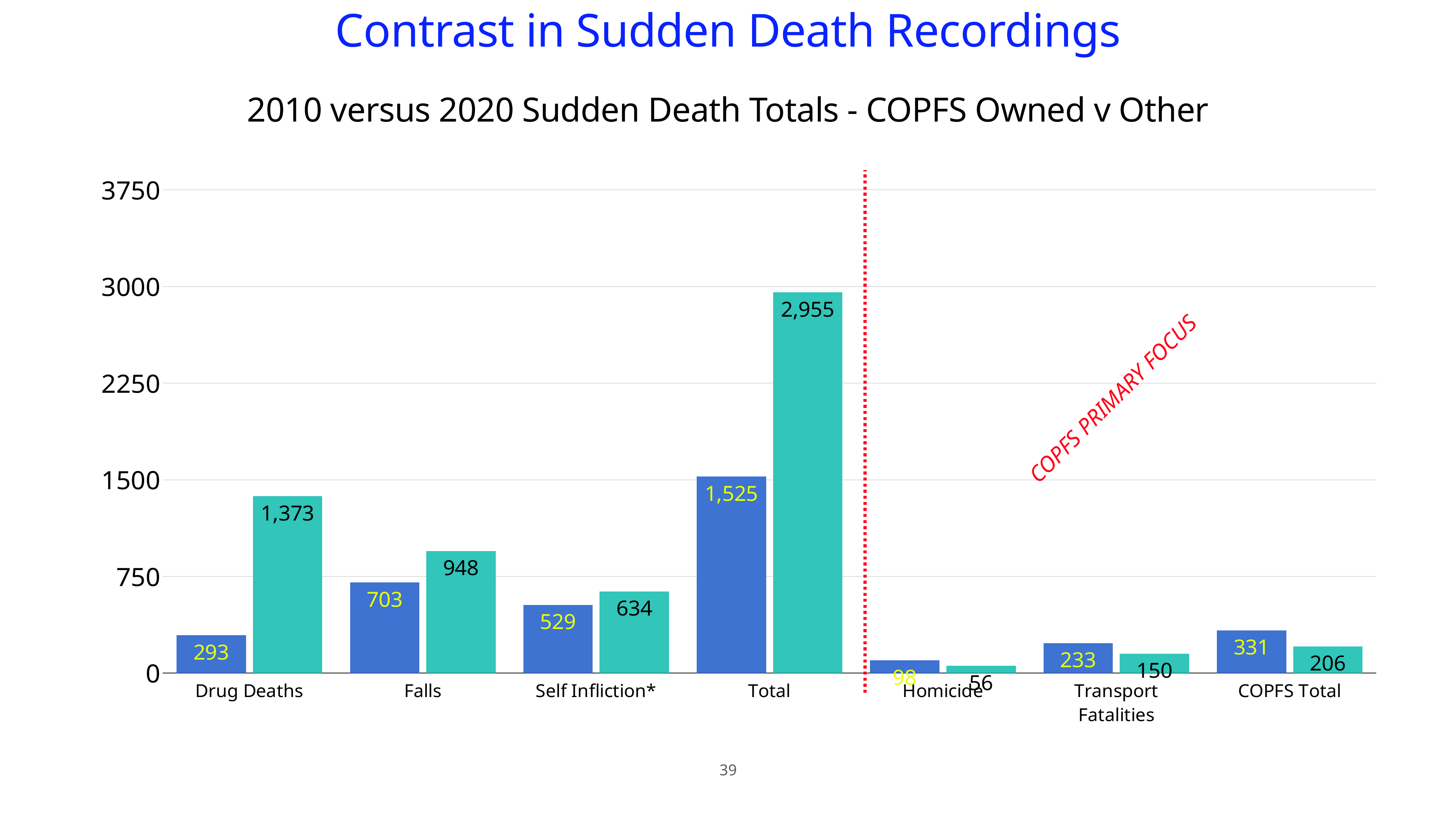
What is the value of the blue bar for Falls? 703 How many categories are shown on the x axis? 7 What is the title of the chart? 2010 versus 2020 Sudden Death Totals - COPFS Owned v Other What kind of chart is shown on the slide? bar chart Which category has the shortest blue bar? Homicide What is the value of the teal bar for Drug Deaths? 1,373 Which category has the tallest teal bar? Total What is the value of the blue bar for Transport Fatalities? 233 What is the value of the teal bar for Homicide? 56 What is the difference between the blue bar and the teal bar for COPFS Total? 125 What is the difference between the teal bar and the blue bar for Total? 1,430 For Self Infliction*, which is larger, the blue bar or the teal bar? the teal bar